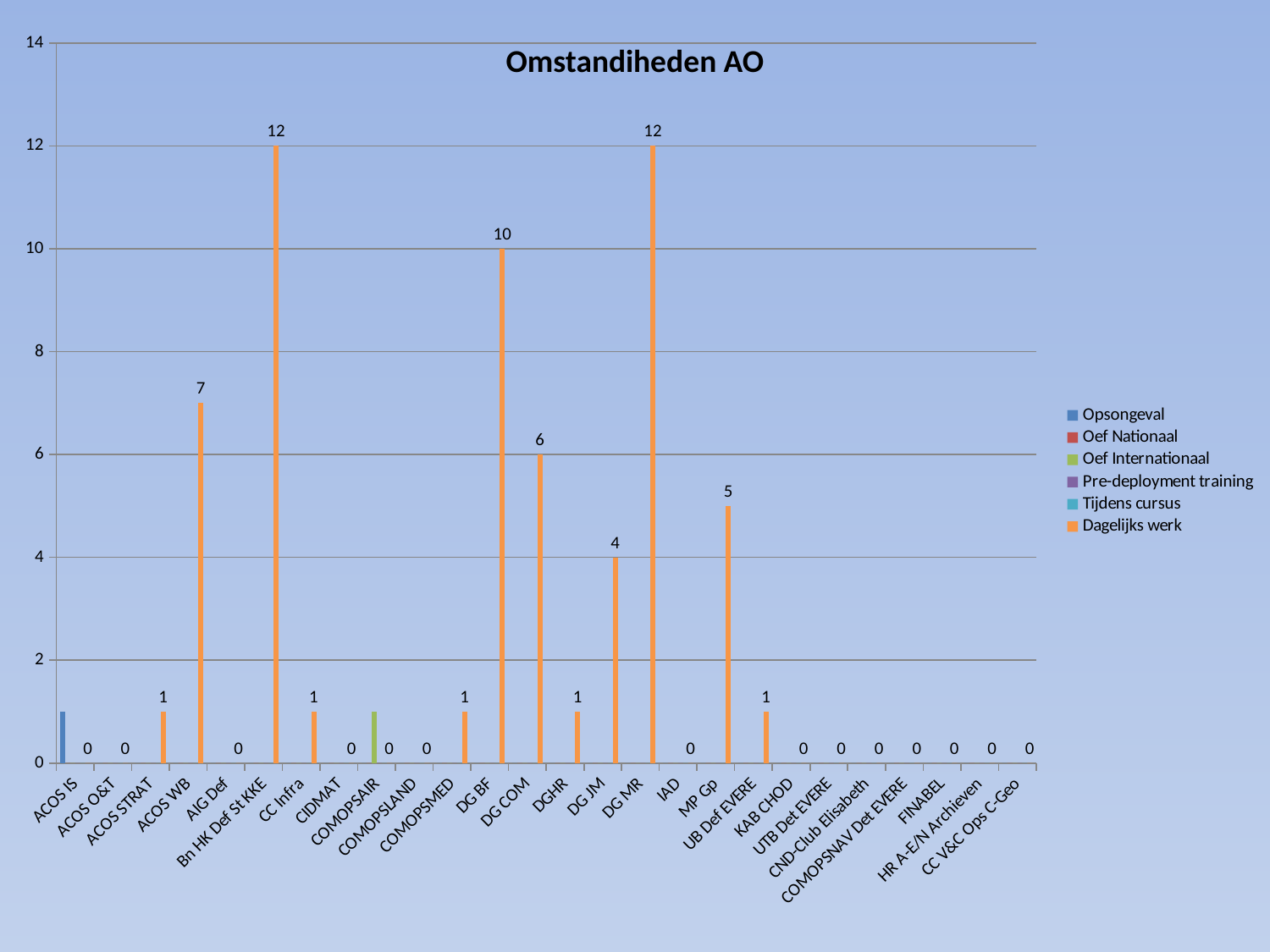
What kind of chart is shown on the slide? bar chart What is the Dagelijks werk value for DG JM? 4 How many categories are shown on the x axis? 26 What is the Dagelijks werk value for DG BF? 10 What is the title of the chart? Omstandiheden AO How many series does the legend list? 6 What is the highest Dagelijks werk value shown in the chart? 12 What is the Dagelijks werk value for ACOS WB? 7 Which has the larger Dagelijks werk value, DG JM or MP Gp? MP Gp What is the Dagelijks werk value for MP Gp? 5 Which series is shown in orange in the legend? Dagelijks werk What is the difference between the Dagelijks werk values for DG BF and DG COM? 4